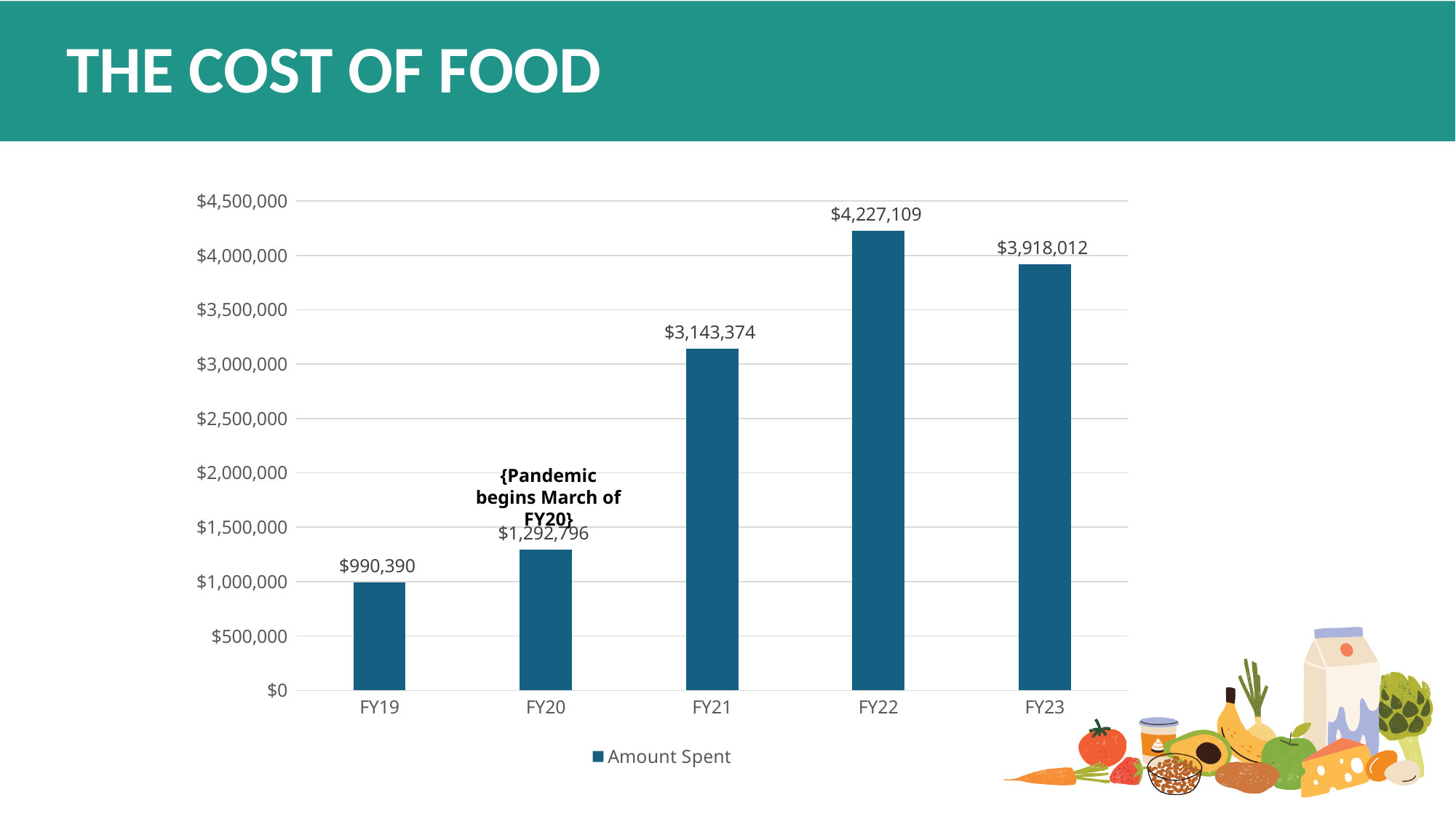
Which fiscal year had the lowest amount spent? FY19 How many fiscal years are shown on the chart? 5 How much more was spent in FY22 than in FY23? $309,097 What was the amount spent in FY23? $3,918,012 What is the difference in amount spent between FY20 and FY19? $302,406 What was the amount spent in FY21? $3,143,374 Which year had a larger amount spent, FY21 or FY23? FY23 Which fiscal year had the highest amount spent? FY22 What type of chart is shown on the slide? bar chart What series name does the legend show? Amount Spent What was the amount spent in FY19? $990,390 Is the amount spent in FY20 greater or less than $1,500,000? less